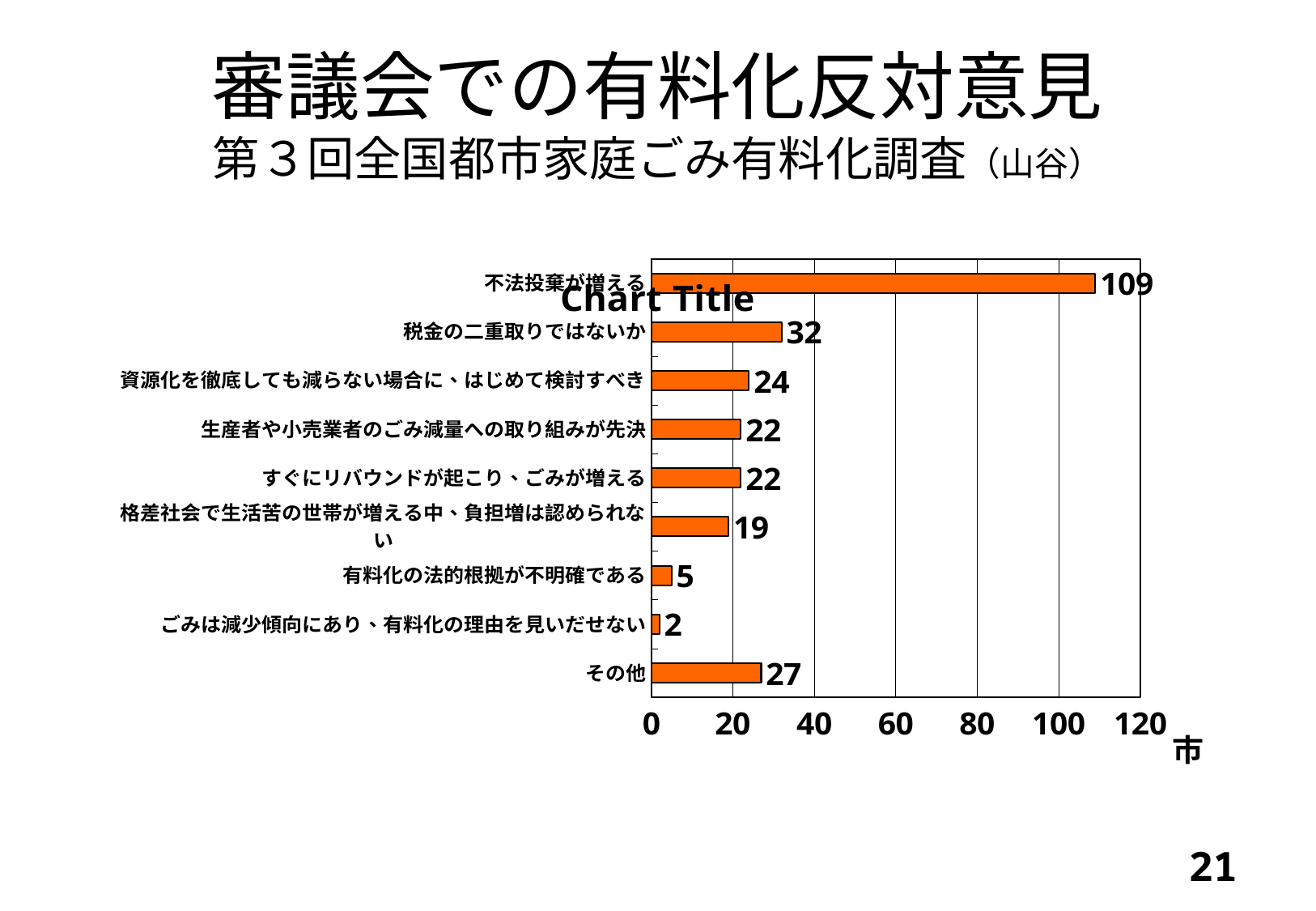
What kind of chart is shown on the slide? bar chart What is the value for 不法投棄が増える? 109 Is the value for 不法投棄が増える greater or less than 100? greater Which category has the highest value? 不法投棄が増える What is the difference between the values for 不法投棄が増える and 税金の二重取りではないか? 77 What is the value for その他? 27 What is the value for 税金の二重取りではないか? 32 How many categories are shown in the chart? 9 Which category has the lowest value? ごみは減少傾向にあり、有料化の理由を見いだせない What unit label is shown at the end of the horizontal axis? 市 What is the value for 有料化の法的根拠が不明確である? 5 Which is larger, the value for 資源化を徹底しても減らない場合に、はじめて検討すべき or the value for その他? その他